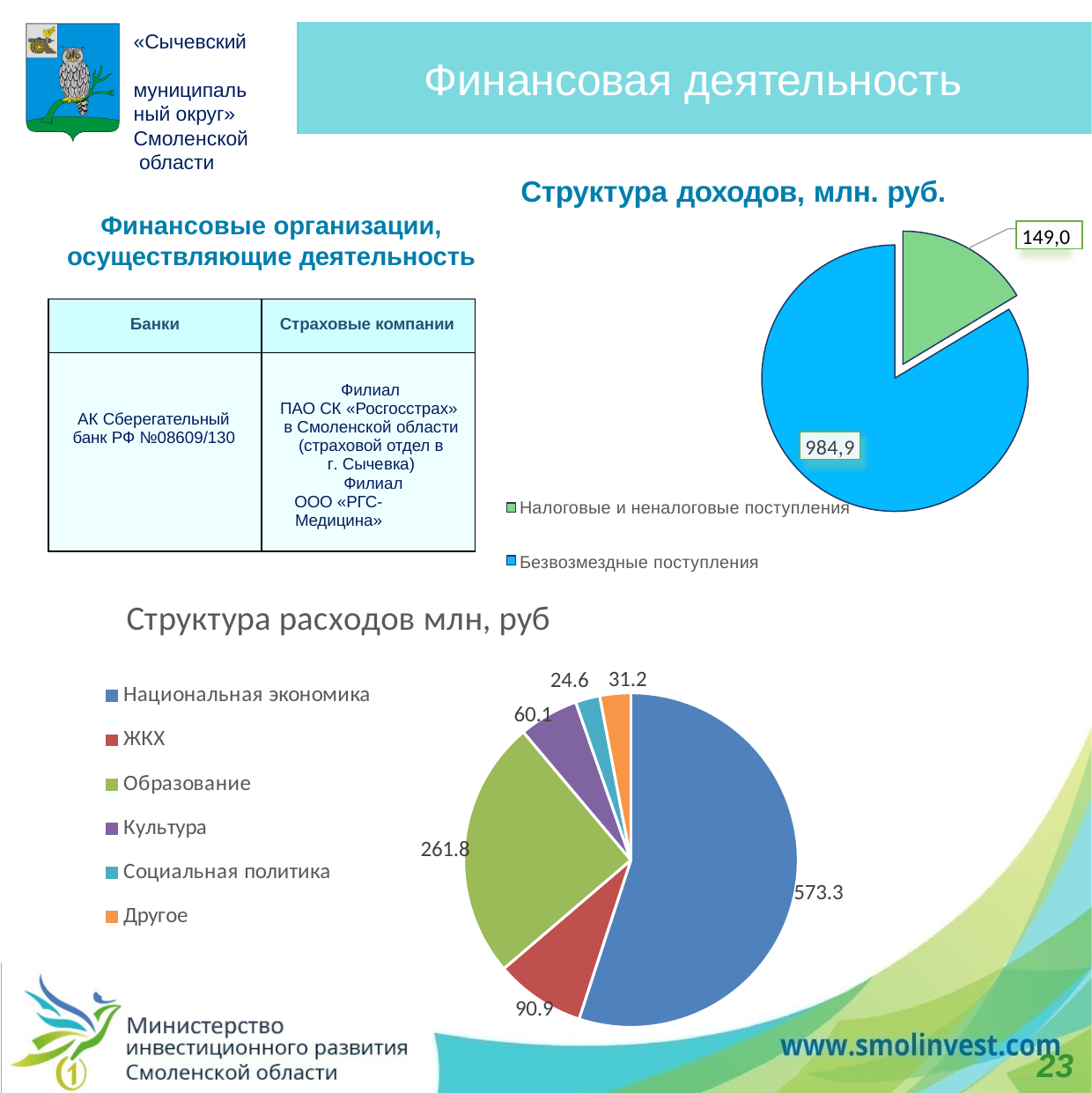
In the chart titled "Структура доходов, млн. руб.", how many categories does the legend list? 2 In the chart titled "Структура доходов, млн. руб.", what is the value for Налоговые и неналоговые поступления? 149,0 In the chart titled "Структура расходов млн, руб", which category has the lowest value? Социальная политика In the chart titled "Структура расходов млн, руб", what is the value for Образование? 261.8 In the chart titled "Структура расходов млн, руб", what is the difference between Национальная экономика and Образование? 311.5 In the chart titled "Структура расходов млн, руб", which is larger: ЖКХ or Культура? ЖКХ In the chart titled "Структура расходов млн, руб", how many categories are shown? 6 In the chart titled "Структура расходов млн, руб", which category has the highest value? Национальная экономика In the chart titled "Структура доходов, млн. руб.", what is the value for Безвозмездные поступления? 984,9 What kind of chart is the one titled "Структура доходов, млн. руб."? pie chart In the chart titled "Структура доходов, млн. руб.", what is the difference between Безвозмездные поступления and Налоговые и неналоговые поступления? 835,9 In the chart titled "Структура расходов млн, руб", what is the value for Социальная политика? 24.6